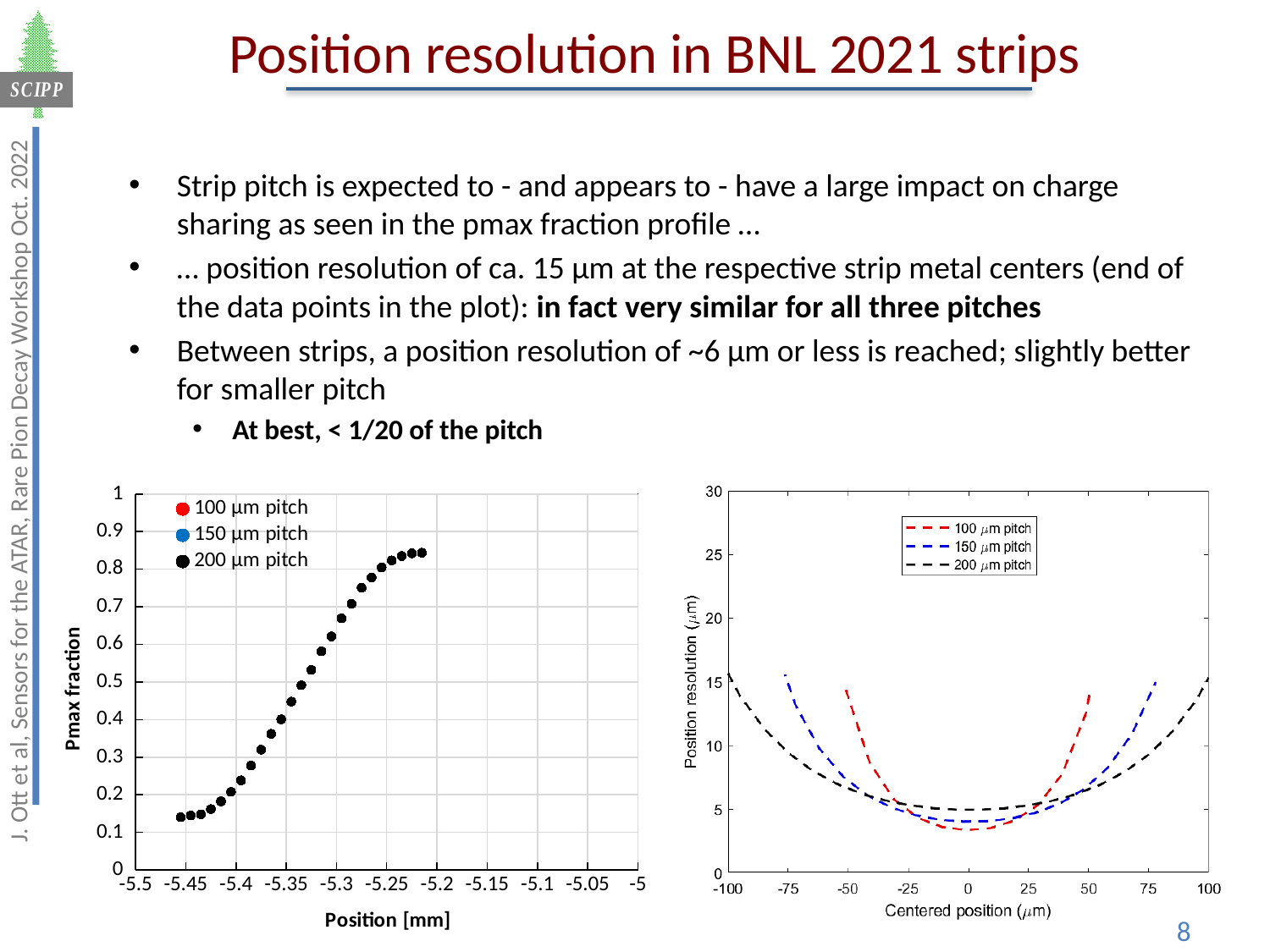
How many series does the legend of the left chart list? 3 In the left chart, do the Pmax fraction values rise or fall as Position increases from -5.45 to -5.2 mm? rise In the right chart, is the position resolution of the 100 µm pitch curve at centered position 0 greater or less than 5? less In the left chart, is the Pmax fraction at Position -5.2 mm greater or less than 0.8? greater In the left chart, is the Pmax fraction at Position -5.45 mm greater or less than 0.2? less In the right chart, which pitch curve extends over the widest range of centered positions? 200 µm pitch What is the label of the x axis of the left chart? Position [mm] In the right chart, what colour is the 150 µm pitch curve? blue How many series does the legend of the right chart list? 3 What kind of chart is the right chart (Position resolution vs Centered position)? line chart In the right chart, at centered position 0, which has the lower position resolution: the 100 µm pitch or the 200 µm pitch? 100 µm pitch What kind of chart is the left chart (Pmax fraction vs Position)? scatter chart